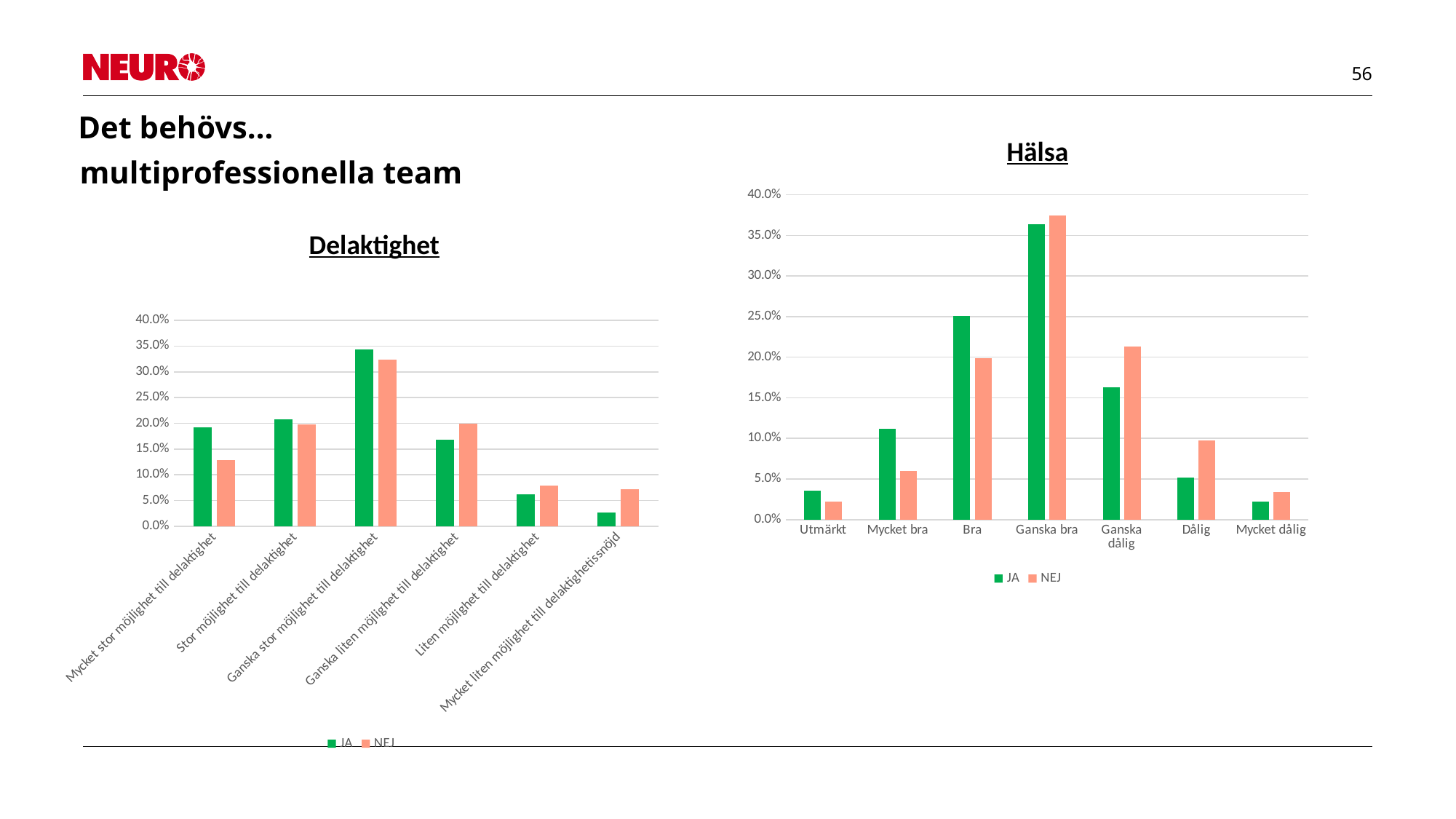
How many categories are shown on the x axis of the Hälsa chart? 7 In the Delaktighet chart, for Mycket stor möjlighet till delaktighet, which series has the larger value, JA or NEJ? JA In the Hälsa chart, is the NEJ value for Mycket bra greater or less than 10.0%? less In the Hälsa chart, for Ganska dålig, which series has the larger value, JA or NEJ? NEJ How many series does the legend of the Hälsa chart list? 2 What are the two legend entries in the Delaktighet chart? JA and NEJ In the Delaktighet chart, is the JA value for Ganska stor möjlighet till delaktighet greater or less than 30.0%? greater In the Delaktighet chart, which category has the highest JA value? Ganska stor möjlighet till delaktighet In the Hälsa chart, is the JA value for Bra greater or less than 20.0%? greater In the Hälsa chart, which category has the lowest NEJ value? Utmärkt In the Hälsa chart, which category has the highest JA value? Ganska bra What kind of chart is the Delaktighet chart? bar chart